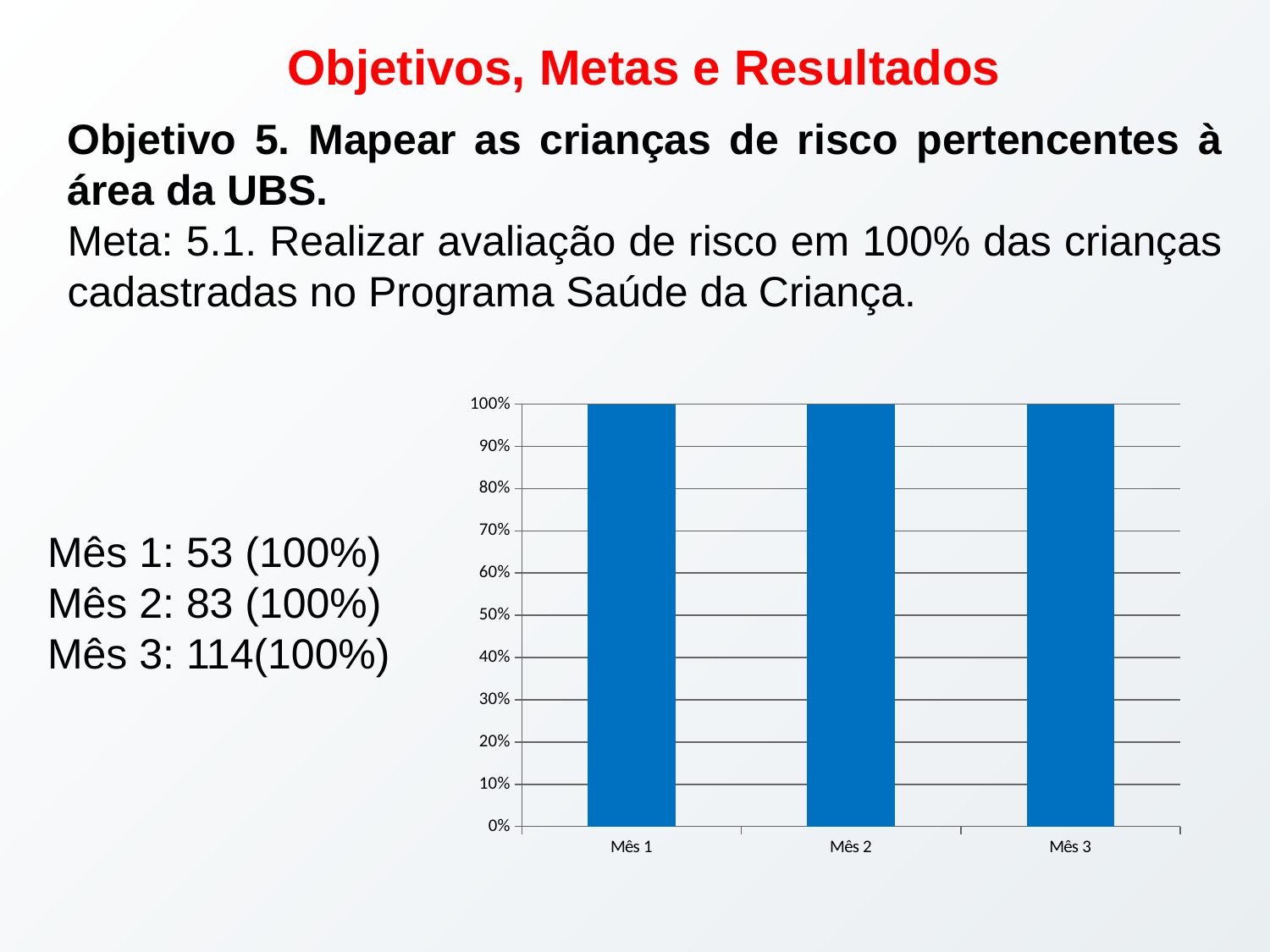
How many categories are shown on the x axis of the chart? 3 What is the highest value shown on the y axis of the chart? 100% What is the value for Mês 3 in the bar chart? 100% Is the value for Mês 1 greater or less than 90%? greater What is the difference between the values for Mês 3 and Mês 1? 0% What is the value for Mês 2 in the bar chart? 100% What kind of chart is shown on the slide? Bar chart Is the value for Mês 2 greater or less than 50%? greater What is the value for Mês 1 in the bar chart? 100% What is the label of the first category on the x axis? Mês 1 Do the values rise, fall, or stay the same from Mês 1 to Mês 3? Stay the same